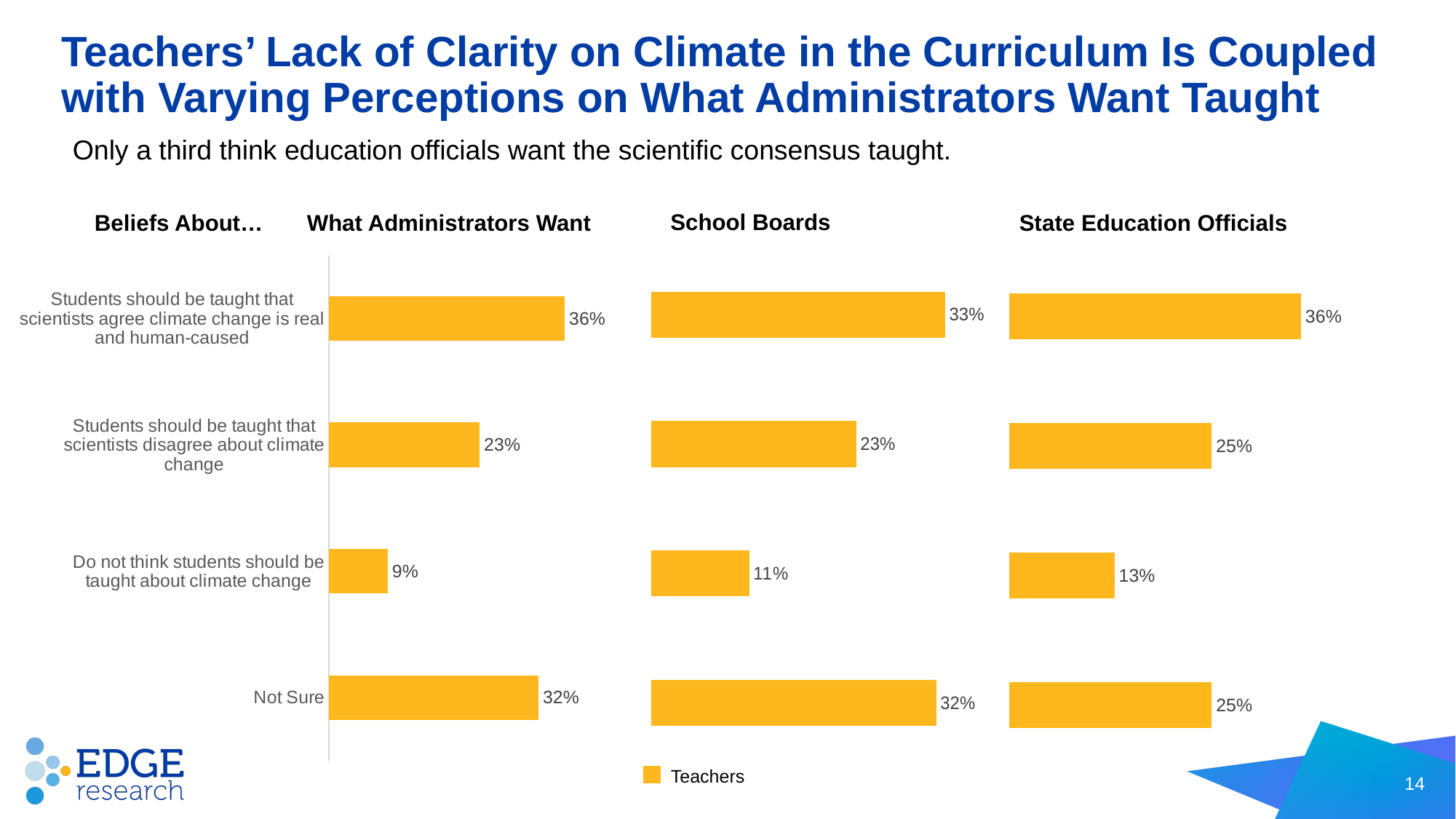
How many categories are shown in the "School Boards" chart? 4 In the "School Boards" chart, what is the value for "Not Sure"? 32% In the "What Administrators Want" chart, what is the difference between the "Not Sure" value and the "Do not think students should be taught about climate change" value? 23 percentage points In the "What Administrators Want" chart, what percentage of teachers believe students should be taught that scientists agree climate change is real and human-caused? 36% Which is larger: the "Students should be taught that scientists disagree about climate change" value in the "State Education Officials" chart or in the "School Boards" chart? State Education Officials How many series does the legend list? 1 What type of chart is the "State Education Officials" chart? Bar chart In the "What Administrators Want" chart, which category has the highest value? Students should be taught that scientists agree climate change is real and human-caused In the "School Boards" chart, which category has the lowest value? Do not think students should be taught about climate change In the "State Education Officials" chart, what is the difference between the value for "Students should be taught that scientists agree climate change is real and human-caused" and the value for "Not Sure"? 11 percentage points What is the name of the series shown in the legend? Teachers In the "State Education Officials" chart, what percentage do not think students should be taught about climate change? 13%